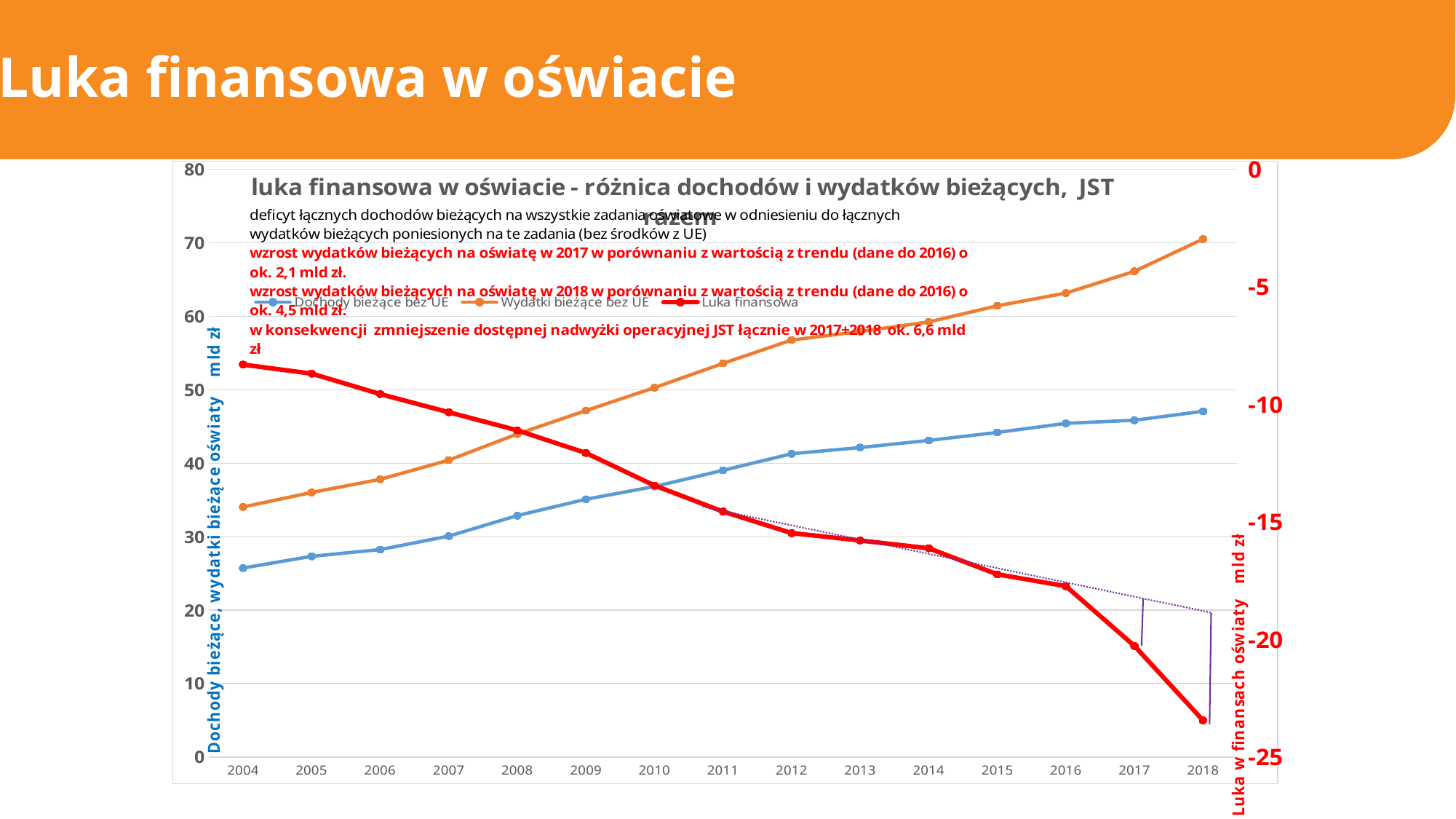
How many series does the chart legend list? 3 Is the value for 'Wydatki bieżące bez UE' in 2018 greater or less than 60? greater In 2018, which series has the higher value: 'Dochody bieżące bez UE' or 'Wydatki bieżące bez UE'? Wydatki bieżące bez UE In which year does 'Wydatki bieżące bez UE' reach its highest value? 2018 Does the 'Luka finansowa' line rise or fall from 2004 to 2018? falls How many years are plotted along the x axis of the chart? 15 In which year is 'Dochody bieżące bez UE' at its lowest value? 2004 Is the value for 'Dochody bieżące bez UE' in 2004 greater or less than 30? less Which series in the legend is drawn in red? Luka finansowa What kind of chart is shown on the slide? line chart Does the 'Wydatki bieżące bez UE' line rise or fall from 2004 to 2018? rises Is the value for 'Wydatki bieżące bez UE' in 2004 greater or less than 40? less